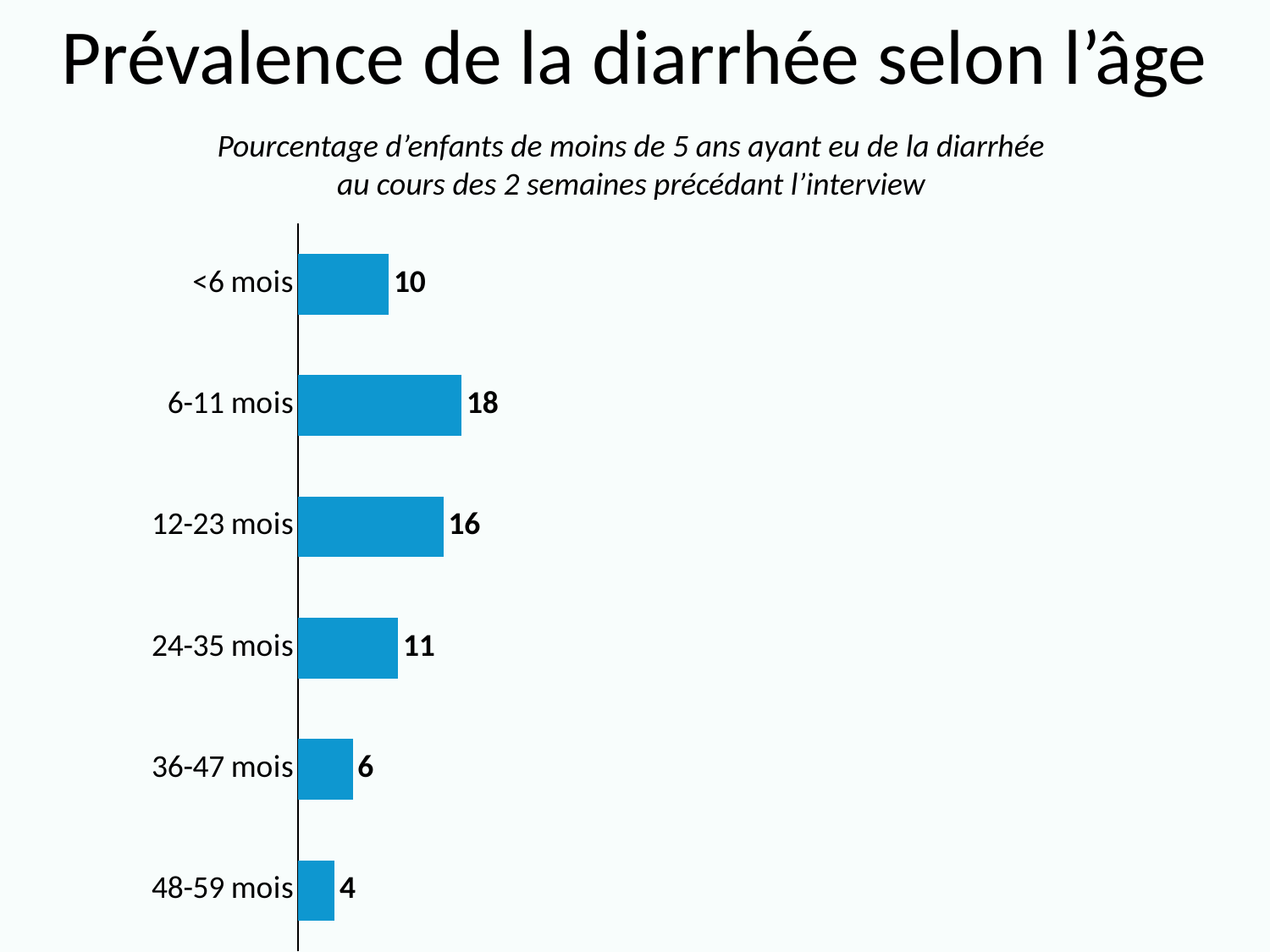
What is the title of the slide? Prévalence de la diarrhée selon l'âge What is the difference between the values for 6-11 mois and 12-23 mois? 2 Which age group has the lowest value? 48-59 mois What is the difference between the values for 36-47 mois and 48-59 mois? 2 What kind of chart is shown on the slide? bar chart What is the value for the 6-11 mois age group? 18 What is the value for the <6 mois age group? 10 How many age groups are shown in the chart? 6 Which is larger, the value for <6 mois or the value for 24-35 mois? 24-35 mois Which age group has the highest value? 6-11 mois What is the value for the 48-59 mois age group? 4 What is the value for the 24-35 mois age group? 11